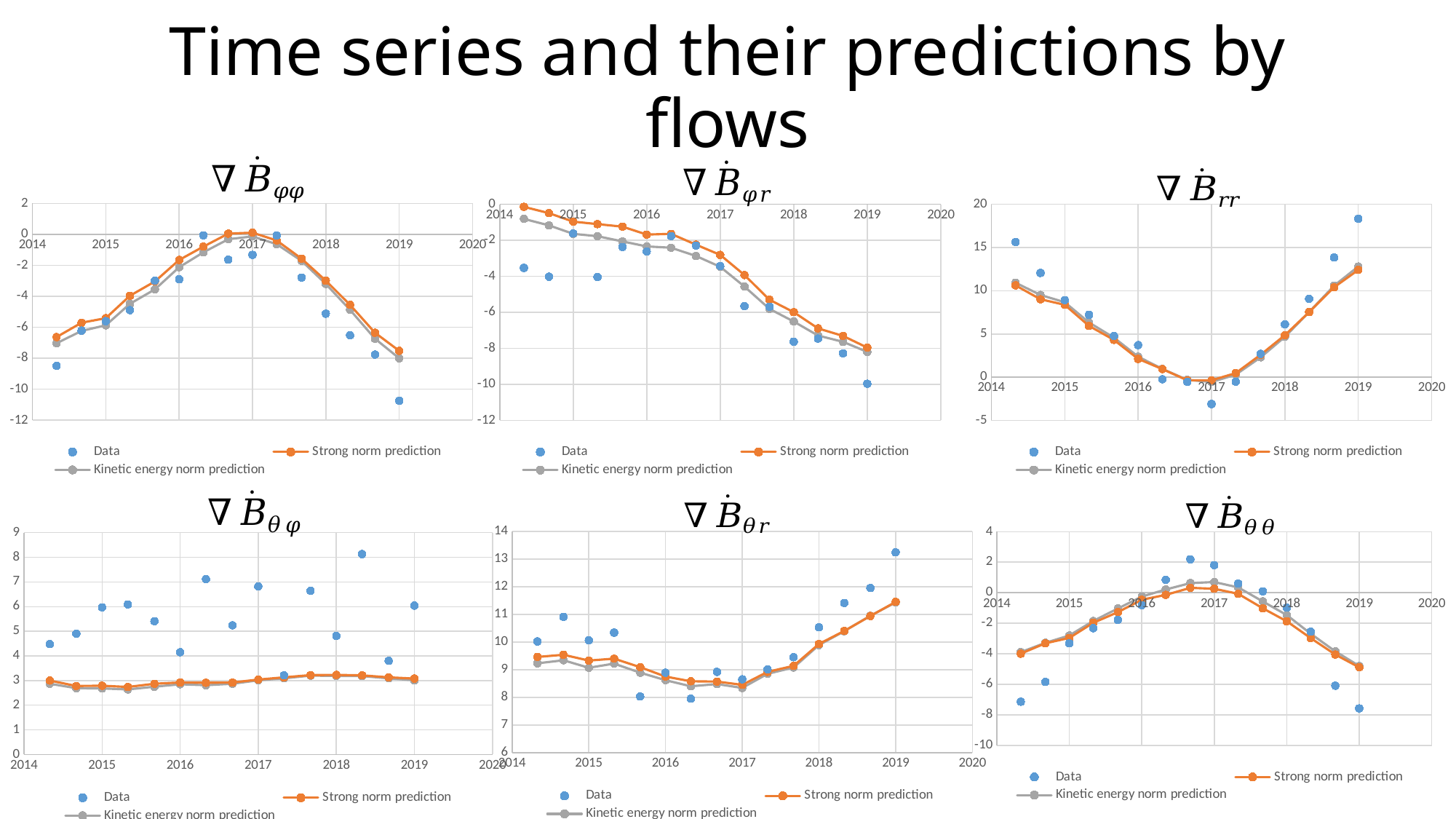
In the top-left chart (∇Ḃ_φφ), how many series does the legend list? 3 In the bottom-right chart (∇Ḃ_θθ), is the Data value at 2019 greater or less than -6? less In the top-right chart (∇Ḃ_rr), is the Data value at 2019 greater or less than 15? greater In the bottom-middle chart (∇Ḃ_θr), is the Data value at 2019 greater or less than 12? greater In the top-middle chart (∇Ḃ_φr), does the Strong norm prediction line rise or fall from 2014 to 2019? fall In the top-right chart (∇Ḃ_rr), which is larger: the Data value at 2019 or the Data value at 2014? 2019 What kind of chart is the top-right chart (∇Ḃ_rr)? scatter chart with lines What colour is the Strong norm prediction line in the charts? orange In the bottom-middle chart (∇Ḃ_θr), does the Strong norm prediction line rise or fall from 2017 to 2019? rise How many charts are shown on the slide? 6